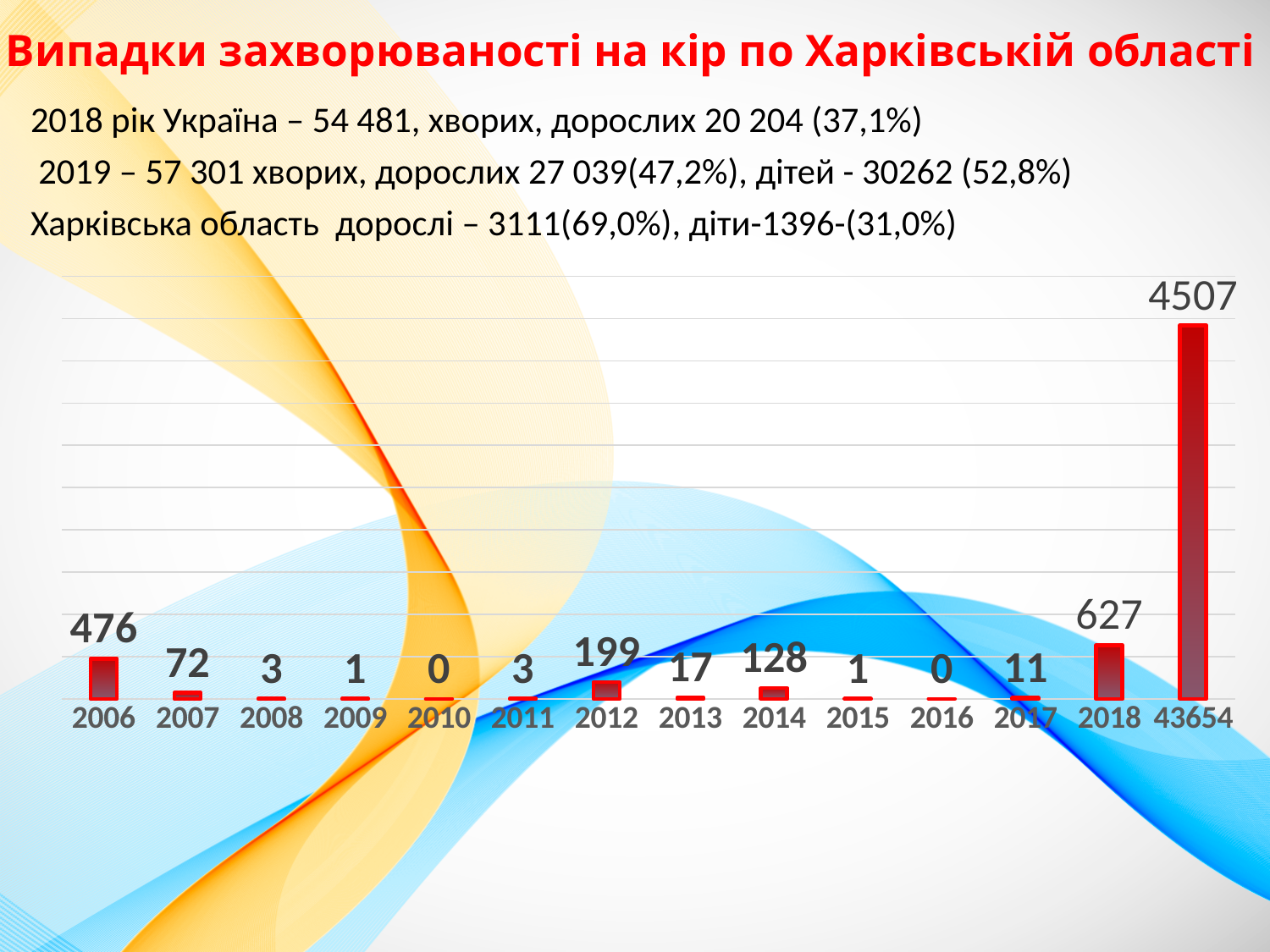
Which is larger, the value for 2012 or the value for 2014? 2012 What kind of chart is shown on the slide? Bar chart What is the value for 2018? 627 What is the value for the last category, labelled 43654? 4507 What is the difference between the values for 2018 and 2006? 151 What is the title of the slide? Випадки захворюваності на кір по Харківській області Which categories have a value of 0? 2010 and 2016 How many categories are shown on the x axis? 14 Which category has the highest value? 43654 What is the value for 2012? 199 What is the value for 2014? 128 What is the value for 2006? 476